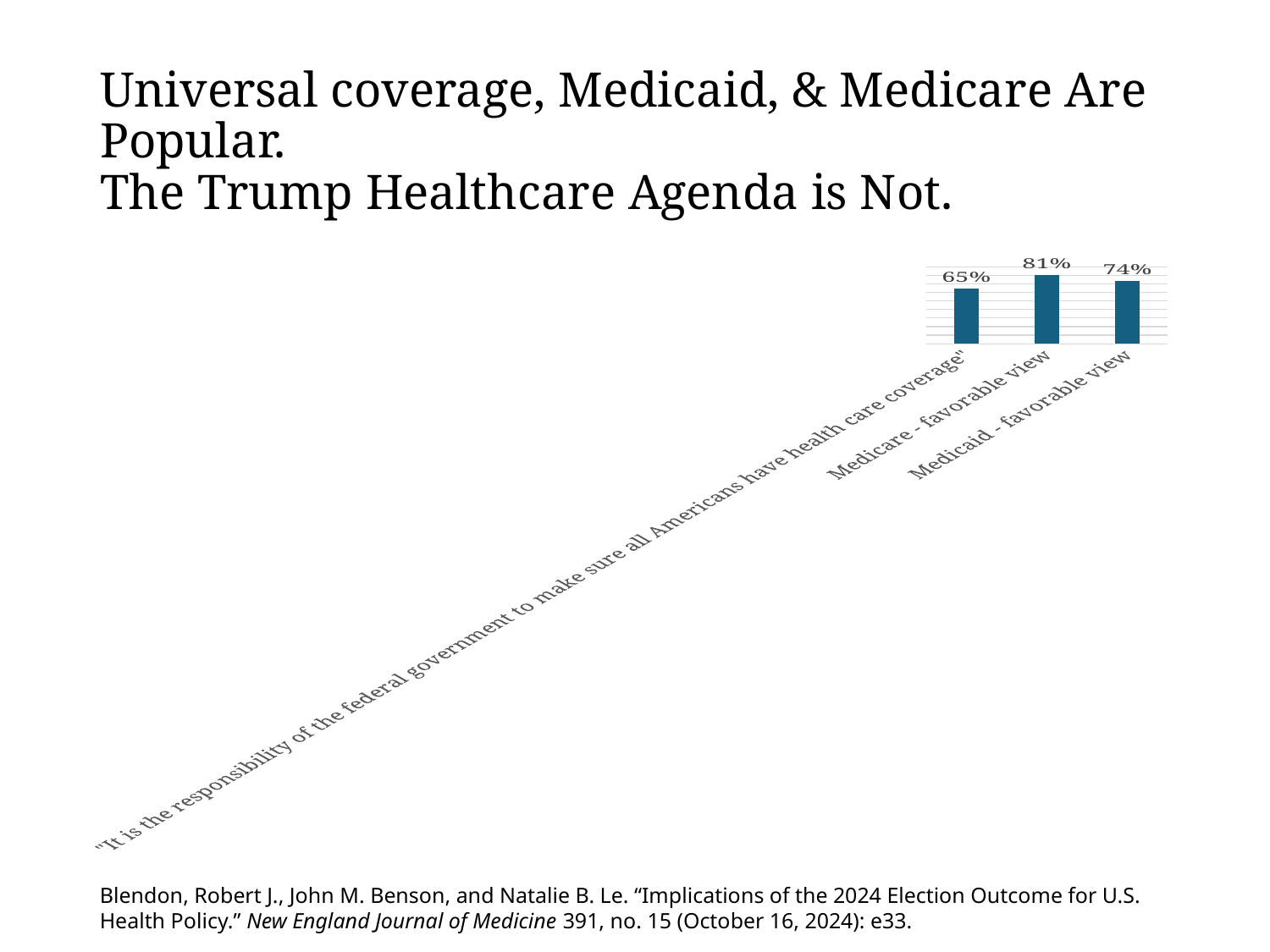
Which category has the highest value? Medicare - favorable view What colour are the bars in the chart? Blue What is the value for the category "It is the responsibility of the federal government to make sure all Americans have health care coverage"? 65% Which is larger: the value for "Medicaid - favorable view" or the value for the federal government responsibility statement? Medicaid - favorable view How many categories are plotted in the chart? 3 What is the difference between the values for "Medicare - favorable view" and the federal government responsibility statement? 16% What is the value for "Medicare - favorable view"? 81% Which category has the lowest value? "It is the responsibility of the federal government to make sure all Americans have health care coverage" What kind of chart is shown on the slide? Bar chart What is the difference between the values for "Medicare - favorable view" and "Medicaid - favorable view"? 7% What is the value for "Medicaid - favorable view"? 74%